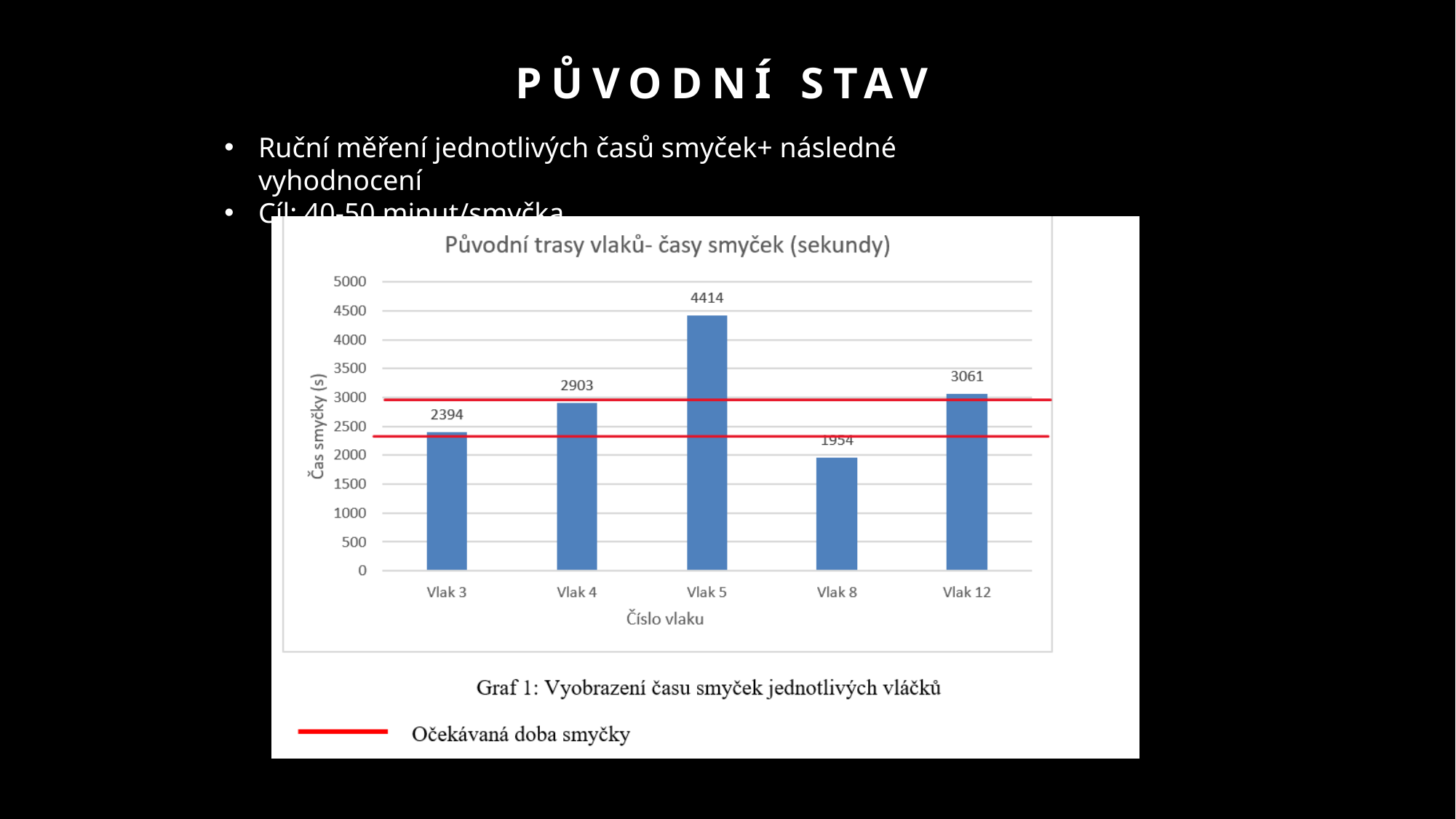
What is the difference between the loop times of Vlak 12 and Vlak 4? 158 Which has a larger loop time, Vlak 3 or Vlak 4? Vlak 4 What is the loop time for Vlak 12? 3061 Which train has the highest loop time? Vlak 5 How many trains are shown on the x axis? 5 What is the loop time for Vlak 8? 1954 Is the value for Vlak 12 greater or less than 3000? greater What is the title of the chart? Původní trasy vlaků- časy smyček (sekundy) Which train has the lowest loop time? Vlak 8 What is the difference between the loop times of Vlak 5 and Vlak 8? 2460 What is the loop time for Vlak 5? 4414 What kind of chart is shown on the slide? bar chart